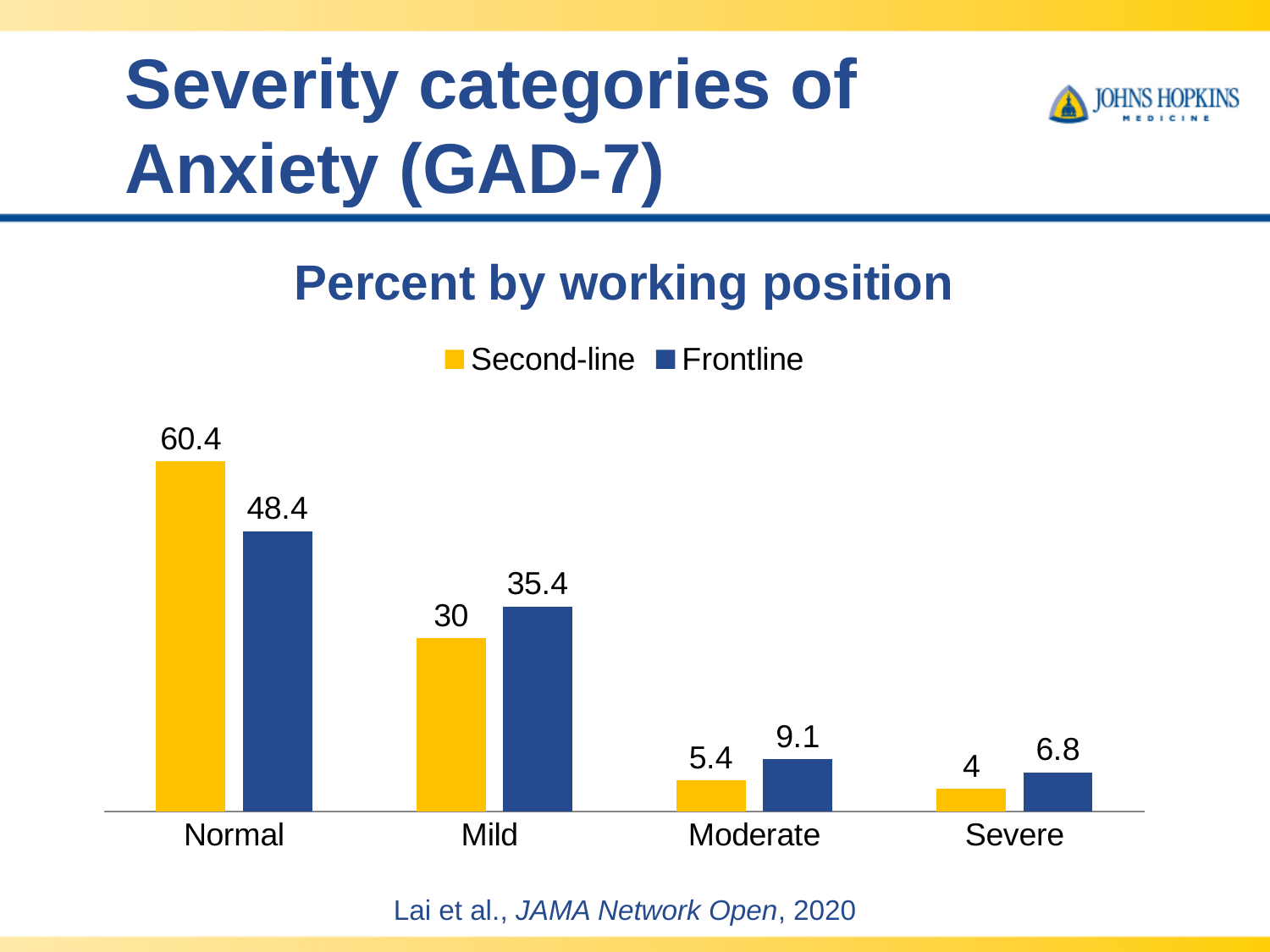
Which category has the highest Frontline value? Normal What is the difference between the Frontline and Second-line values for the Mild category? 5.4 What is the Frontline value for the Mild category? 35.4 What is the Frontline value for the Moderate category? 9.1 Which is larger for the Moderate category, the Second-line value or the Frontline value? Frontline What kind of chart is shown on the slide? Bar chart What is the Second-line value for the Severe category? 4 How many series does the legend list? 2 What is the Second-line value for the Normal category? 60.4 Which category has the lowest Second-line value? Severe How many categories are shown on the x axis? 4 What is the difference between the Second-line and Frontline values for the Normal category? 12